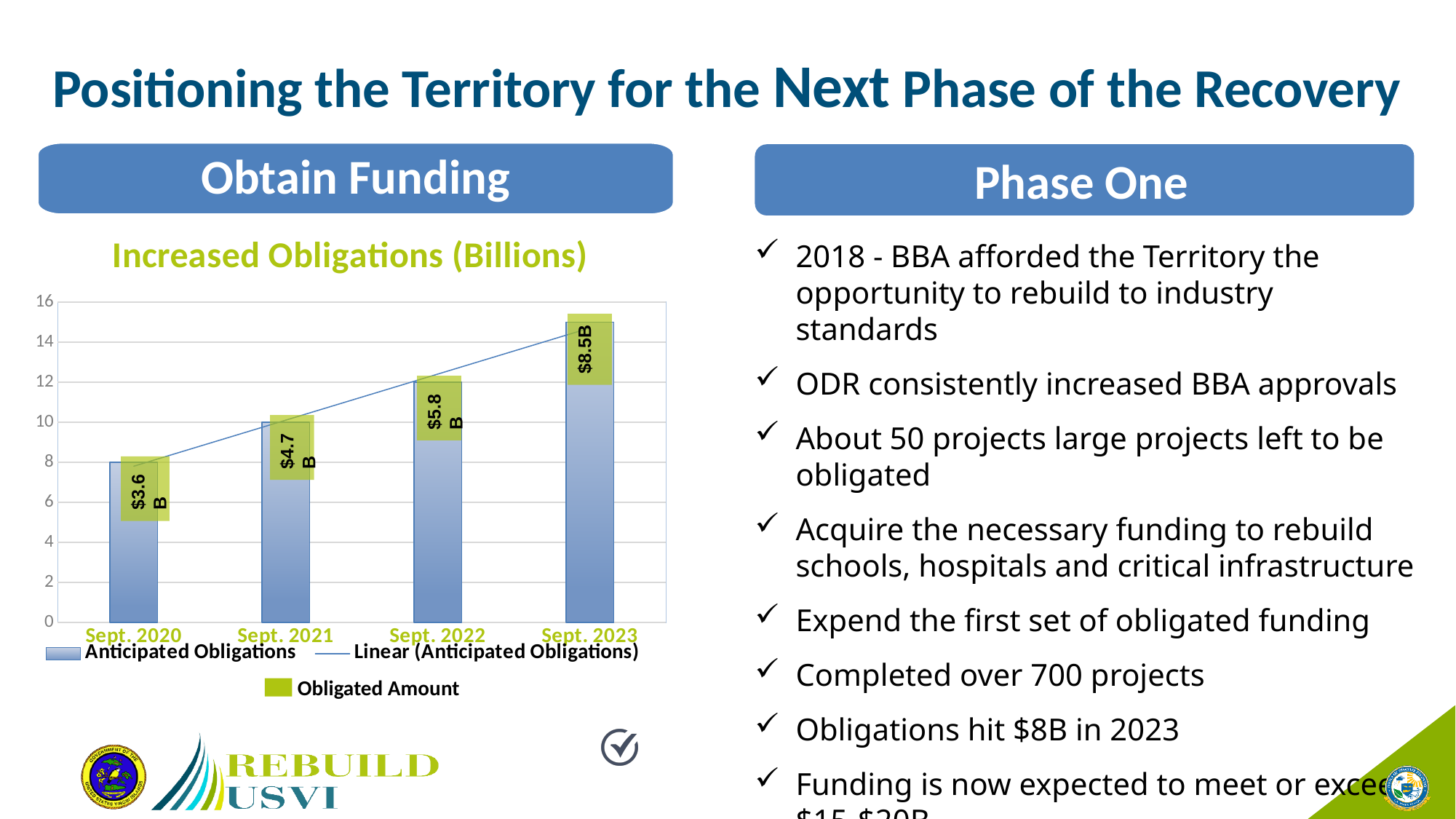
What is the obligated amount labelled for Sept. 2023? $8.5B Do the obligated amounts rise or fall from Sept. 2020 to Sept. 2023? rise Which has the larger obligated amount, Sept. 2021 or Sept. 2022? Sept. 2022 How many periods are shown on the x axis of the chart? 4 Is the Anticipated Obligations bar for Sept. 2020 greater or less than 10? less What is the obligated amount labelled for Sept. 2022? $5.8 B How many entries does the chart legend list? 3 Which period has the highest obligated amount? Sept. 2023 What is the obligated amount labelled for Sept. 2020? $3.6 B What is the difference between the obligated amounts for Sept. 2023 and Sept. 2020? $4.9 B Which period has the lowest obligated amount? Sept. 2020 Is the Anticipated Obligations bar for Sept. 2023 greater or less than 14? greater